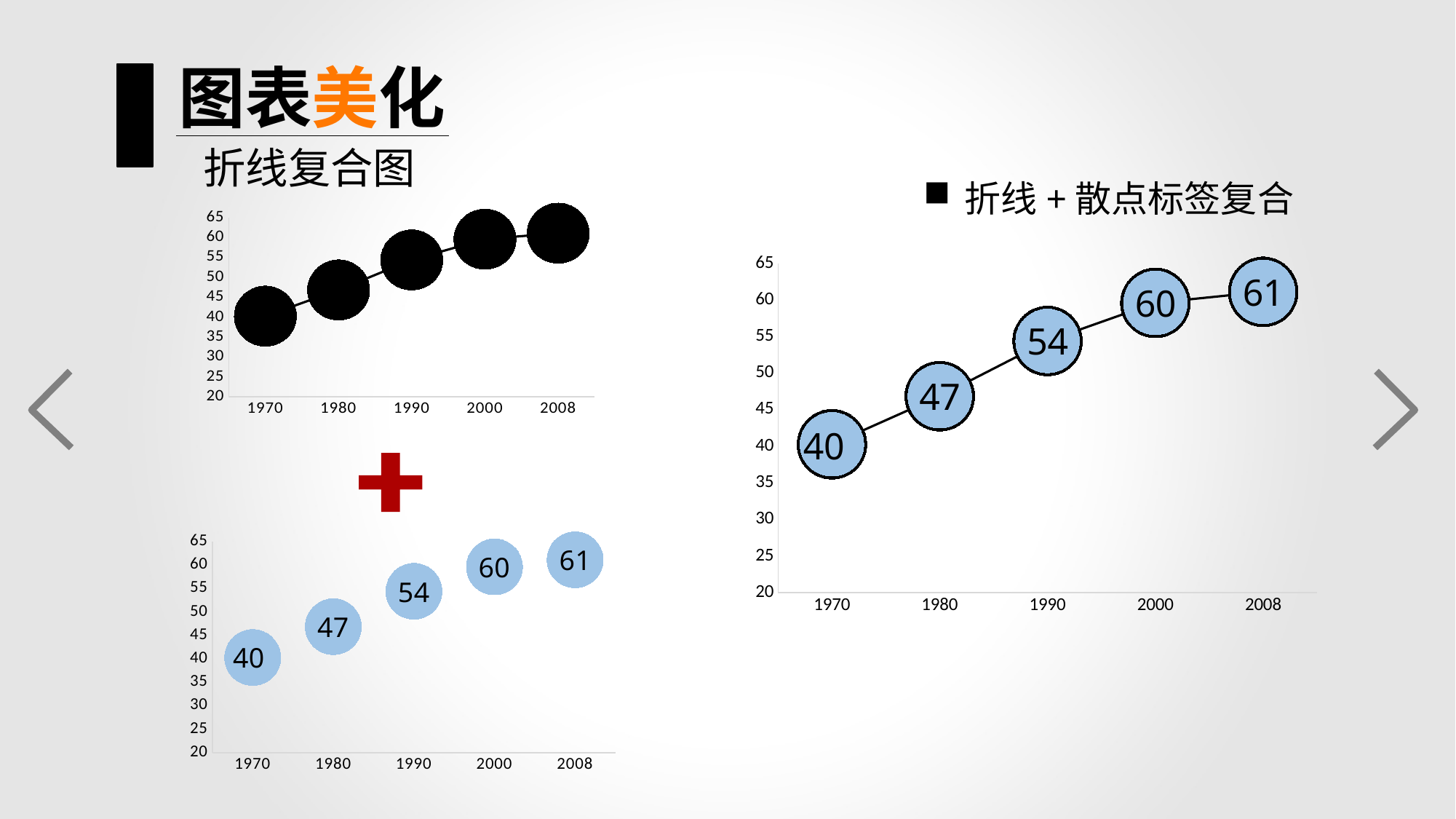
On the top-left chart, is the value for 2008 greater or less than 55? greater On the right-hand chart, which year has the highest value? 2008 On the right-hand chart, what is the value for 1990? 54 On the right-hand chart, what is the difference between the values for 2000 and 1970? 20 What kind of chart is the top-left chart? line chart What is the text of the bullet point above the right-hand chart? 折线＋散点标签复合 On the right-hand chart, how many data points are plotted? 5 On the right-hand chart, do the values rise or fall from 1970 to 2008? rise On the right-hand chart, which is larger, the value for 1990 or the value for 1980? 1990 On the bottom-left chart, what is the value for 2000? 60 On the right-hand chart, what is the value for 1980? 47 On the right-hand chart, which year has the lowest value? 1970